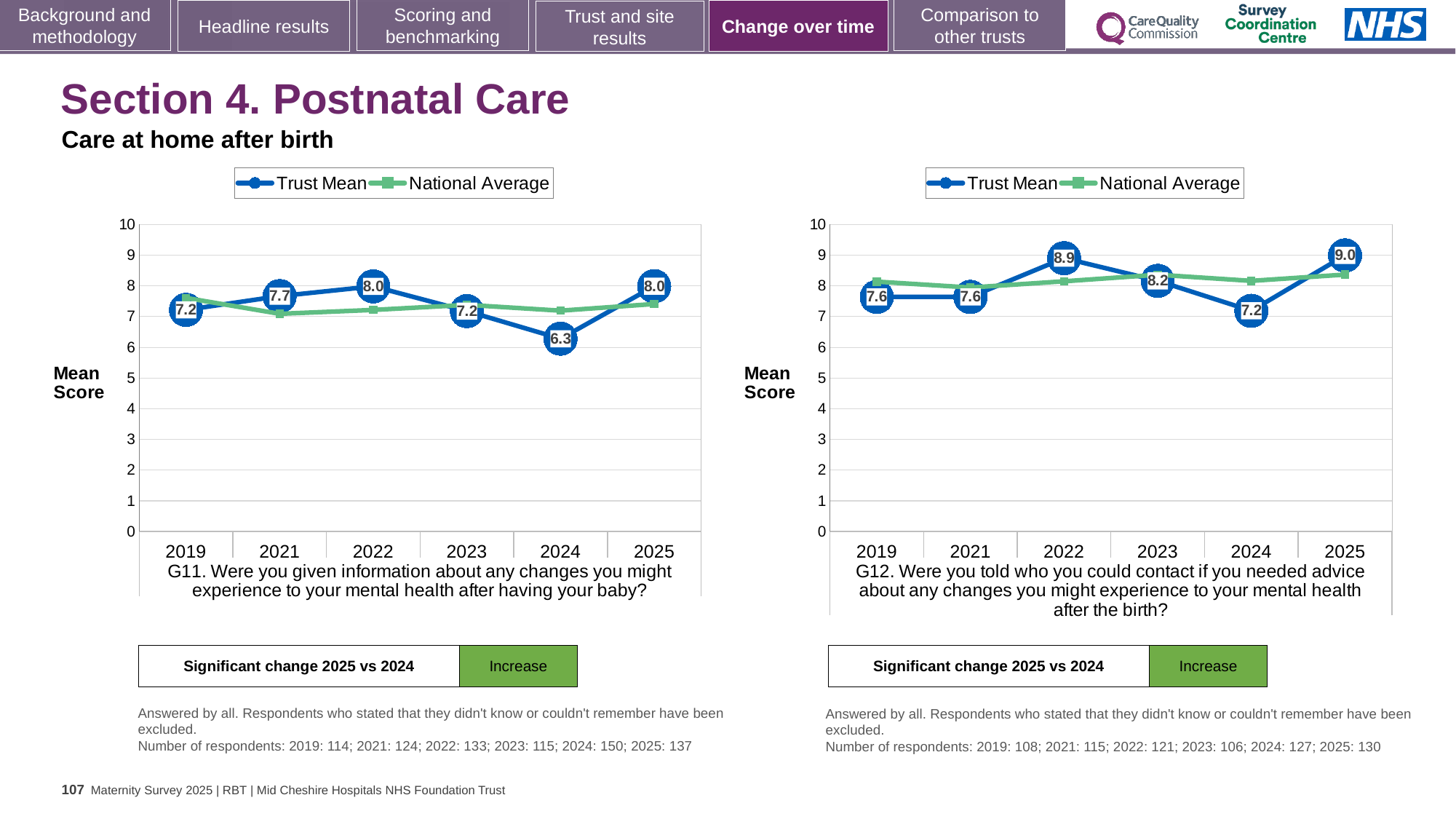
On the G12 chart, in which year is the Trust Mean lowest? 2024 How many years are shown on the x axis of the G12 chart? 6 On the G11 chart, is the National Average for 2024 greater or less than 8? less On the G11 chart, what is the Trust Mean score for 2024? 6.3 On the G12 chart, what is the Trust Mean score for 2025? 9.0 On the G12 chart, is the Trust Mean higher in 2023 or in 2024? 2023 On the G12 chart, what is the Trust Mean score for 2022? 8.9 On the G11 chart, what is the Trust Mean score for 2021? 7.7 On the G12 chart, what is the difference between the Trust Mean in 2022 and in 2023? 0.7 On the G11 chart, what is the difference between the Trust Mean in 2025 and in 2024? 1.7 How many series does the legend of the G11 chart list? 2 On the G11 chart, in which year is the Trust Mean lowest? 2024